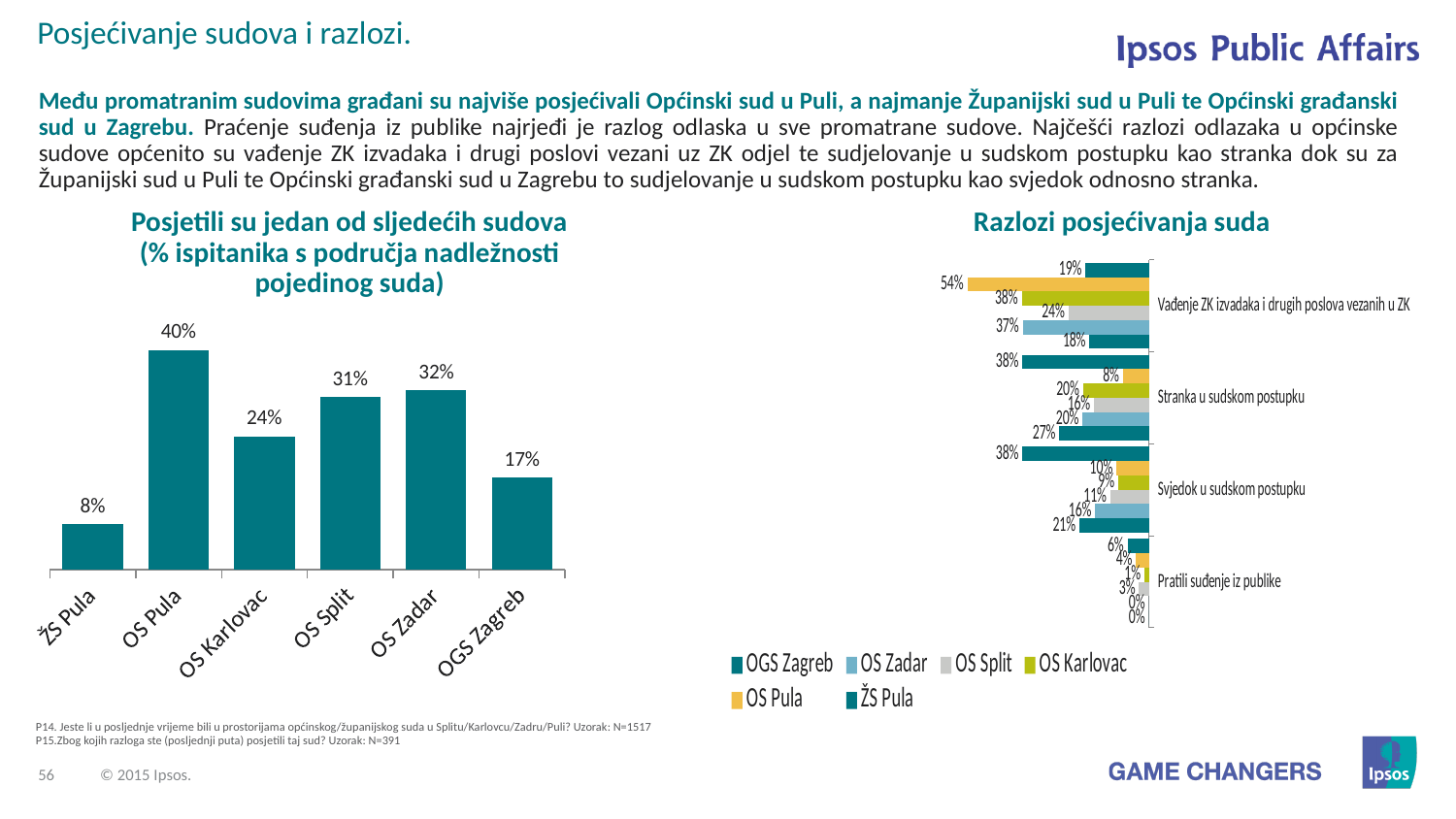
In the chart 'Posjetili su jedan od sljedećih sudova', what is the difference between OS Pula and OS Karlovac? 16 percentage points How many courts are shown in the chart 'Posjetili su jedan od sljedećih sudova'? 6 In the chart 'Razlozi posjećivanja suda', what is the largest value shown for 'Vađenje ZK izvadaka i drugih poslova vezanih u ZK'? 54% How many reasons (categories) are shown in the chart 'Razlozi posjećivanja suda'? 4 What kind of chart is 'Posjetili su jedan od sljedećih sudova'? Bar chart Which series is listed first in the legend of the chart 'Razlozi posjećivanja suda'? OGS Zagreb How many series does the legend of the chart 'Razlozi posjećivanja suda' list? 6 In the chart 'Posjetili su jedan od sljedećih sudova', what is the value for OS Pula? 40% In the chart 'Posjetili su jedan od sljedećih sudova', which court has the highest value? OS Pula In the chart 'Posjetili su jedan od sljedećih sudova', which court has the lowest value? ŽS Pula In the chart 'Posjetili su jedan od sljedećih sudova', what is the value for OGS Zagreb? 17% In the chart 'Posjetili su jedan od sljedećih sudova', which is larger: OS Split or OS Karlovac? OS Split